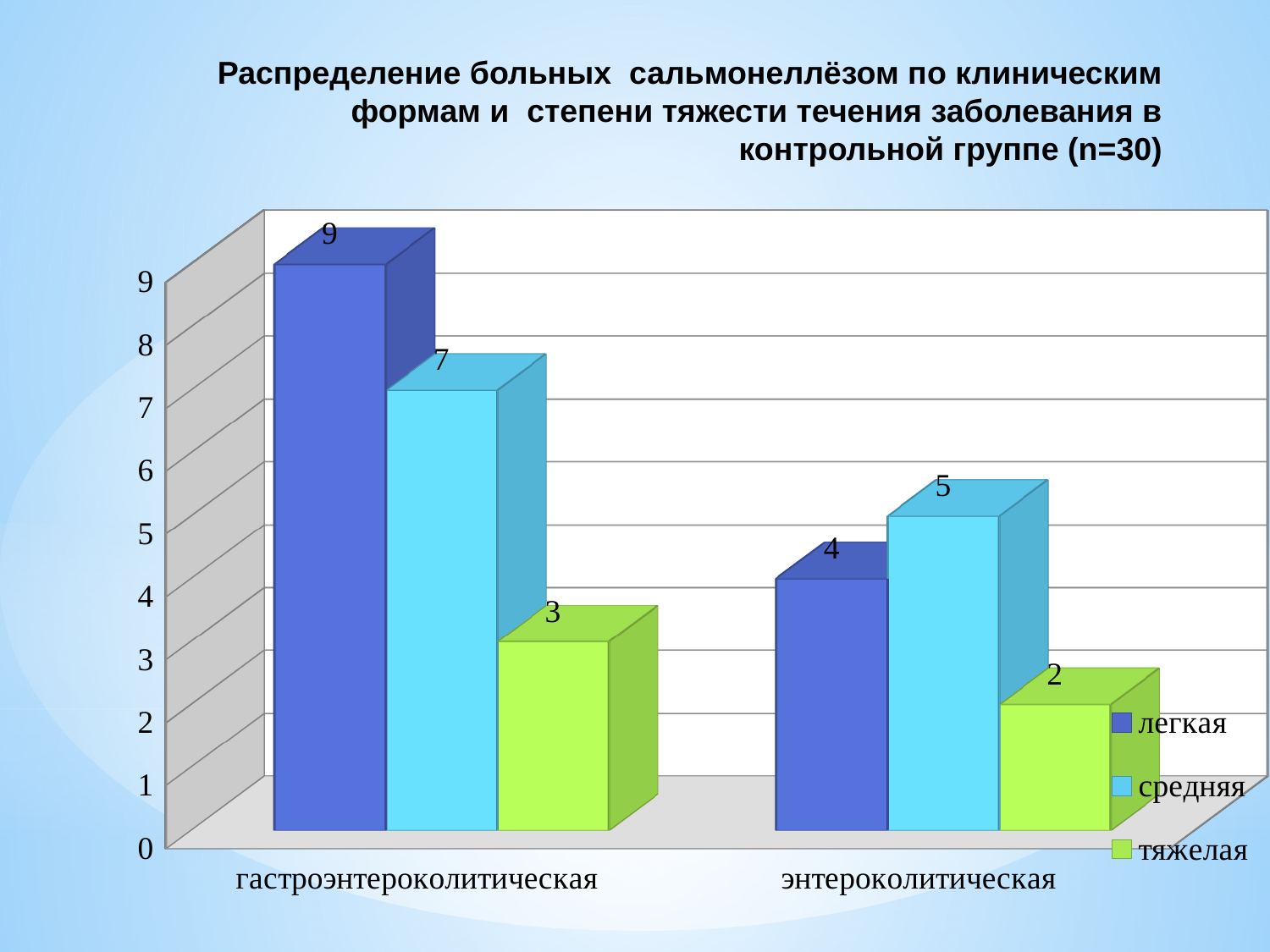
Which is larger in the энтероколитическая category: легкая or средняя? средняя Is the value for средняя in the гастроэнтероколитическая category greater or less than 5? greater What is the value for тяжелая in the гастроэнтероколитическая category? 3 What is the value for средняя in the энтероколитическая category? 5 What colour represents the тяжелая series? green Which severity series has the highest value in the гастроэнтероколитическая category? легкая What is the difference between the легкая values for гастроэнтероколитическая and энтероколитическая? 5 What is the value for легкая in the гастроэнтероколитическая category? 9 What kind of chart is shown on the slide? bar chart How many clinical form categories are shown on the x axis? 2 How many series does the legend list? 3 Which severity series has the lowest value in the энтероколитическая category? тяжелая